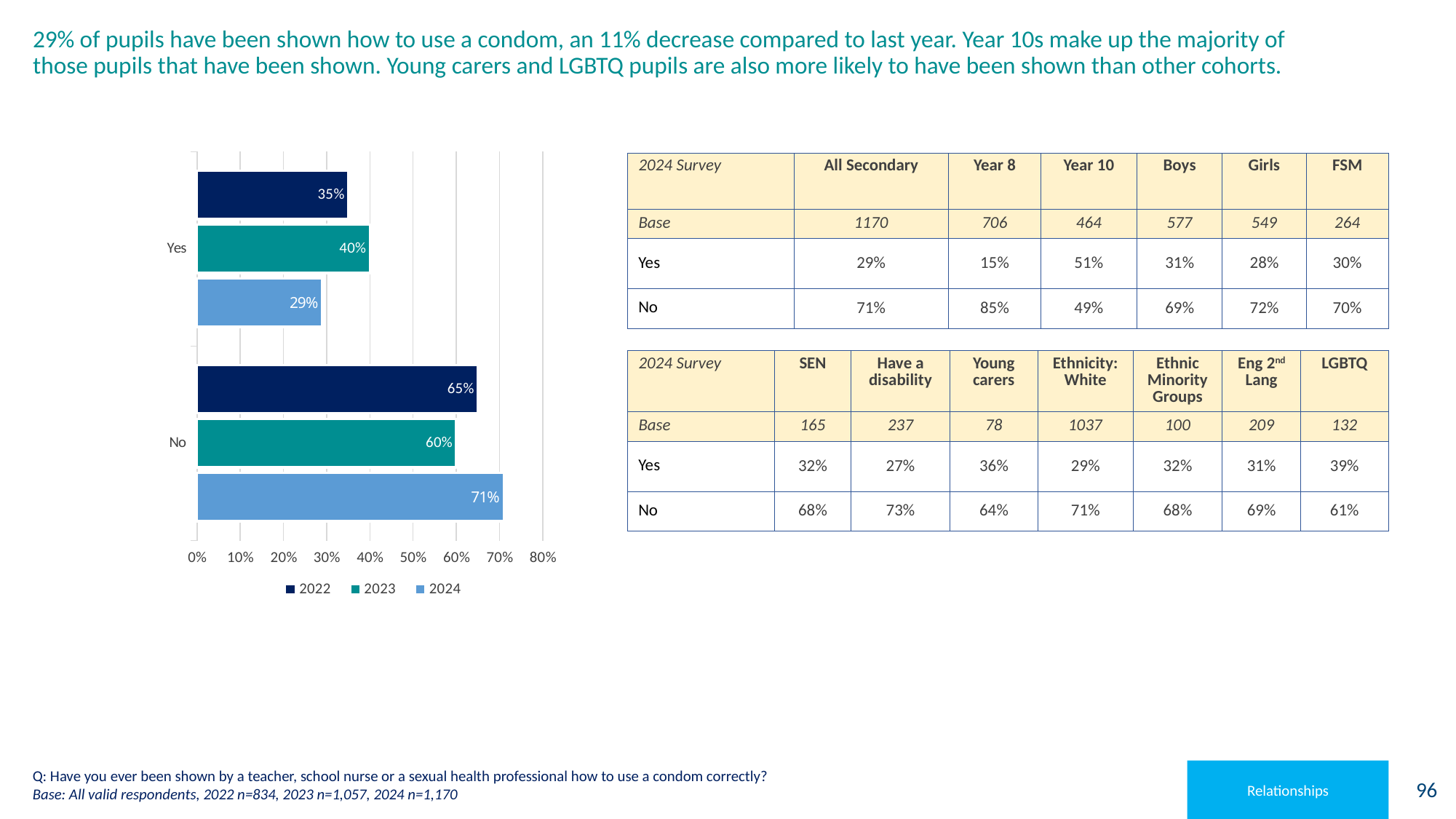
Which year has the lowest value for 'No'? 2023 What is the value for 'No' in 2022? 65% Which year has the highest value for 'Yes'? 2023 What is the difference between the 'Yes' values for 2023 and 2024? 11% Which series is shown in the darkest blue colour in the legend? 2022 What is the value for 'Yes' in 2023? 40% How many series does the legend list? 3 Which is larger, the 'No' value for 2022 or the 'No' value for 2024? 2024 How many categories are shown on the chart's vertical axis? 2 What kind of chart is shown on the slide? bar chart What is the value for 'Yes' in 2024? 29% What is the value for 'No' in 2024? 71%